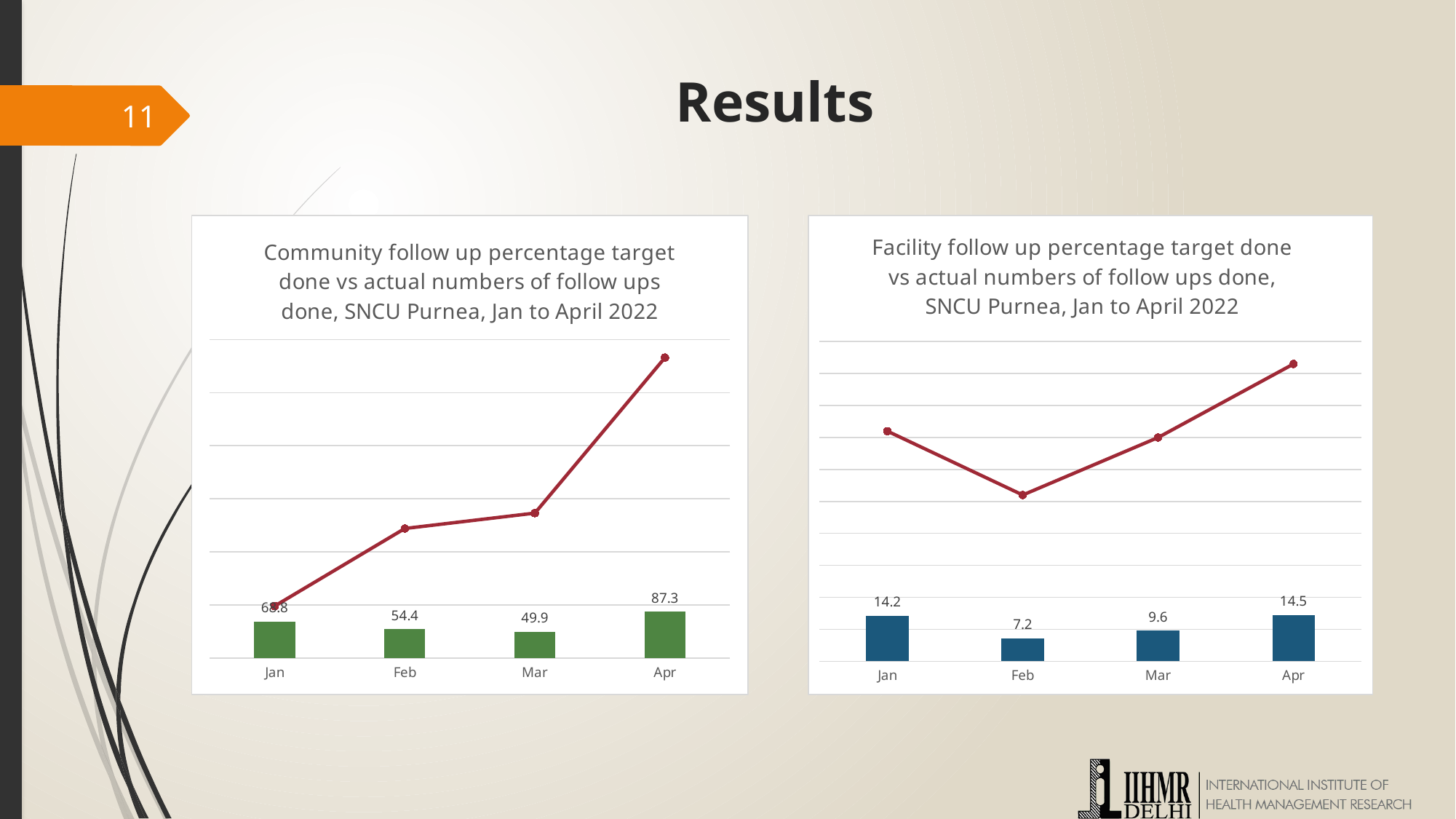
In the Facility follow up chart on the right, what is the bar value for Mar? 9.6 In the Facility follow up chart on the right, what is the bar value for Feb? 7.2 In the Community follow up chart on the left, which month has the highest bar value? Apr In the Facility follow up chart on the right, which month has the lowest bar value? Feb In the Facility follow up chart on the right, what is the difference between the Jan and Feb bar values? 7.0 In the Community follow up chart on the left, which month has the lowest bar value? Mar In the Community follow up chart on the left, what is the bar value for Apr? 87.3 In the Community follow up chart on the left, does the line rise or fall from Jan to Apr? rises In the Community follow up chart on the left, what is the bar value for Feb? 54.4 In the Community follow up chart on the left, what is the bar value for Mar? 49.9 In the Community follow up chart on the left, what is the difference between the Apr and Feb bar values? 32.9 In the Facility follow up chart on the right, how many months are shown on the x axis? 4